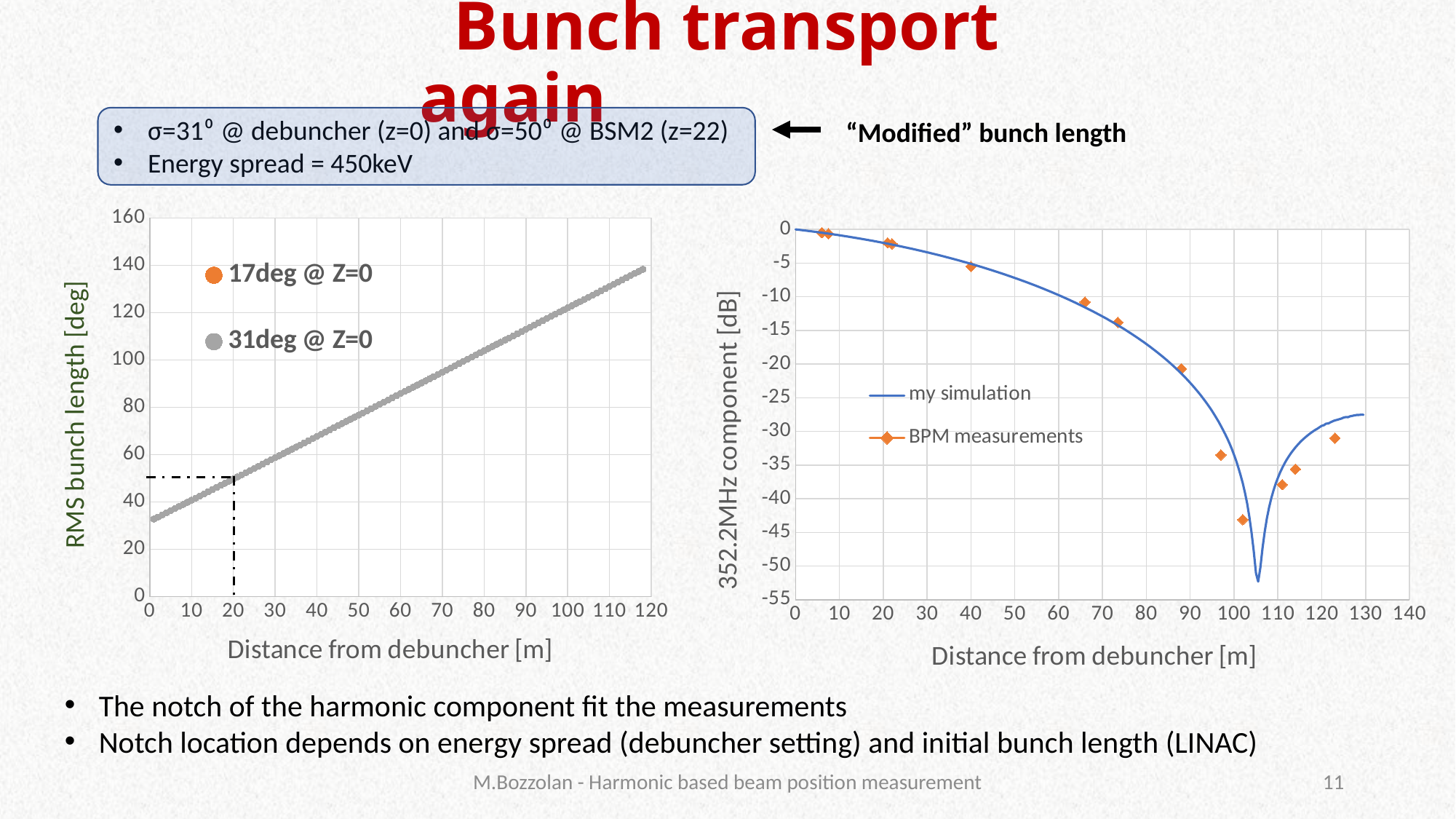
In the left chart, is the RMS bunch length at a distance of 0 m greater or less than 40? less In the left chart, what is the highest value shown on the y axis? 160 In the right chart, how many series does the legend list? 2 In the right chart, what is the largest value shown on the x axis? 140 In the right chart, what are the names of the two series in the legend? my simulation, BPM measurements In the left chart, is the RMS bunch length at a distance of 100 m greater or less than 100? greater In the left chart, does the RMS bunch length rise or fall as the distance from debuncher increases? rise In the right chart, is the lowest point of the 'my simulation' curve greater or less than -50? less In the left chart, how many series does the legend list? 2